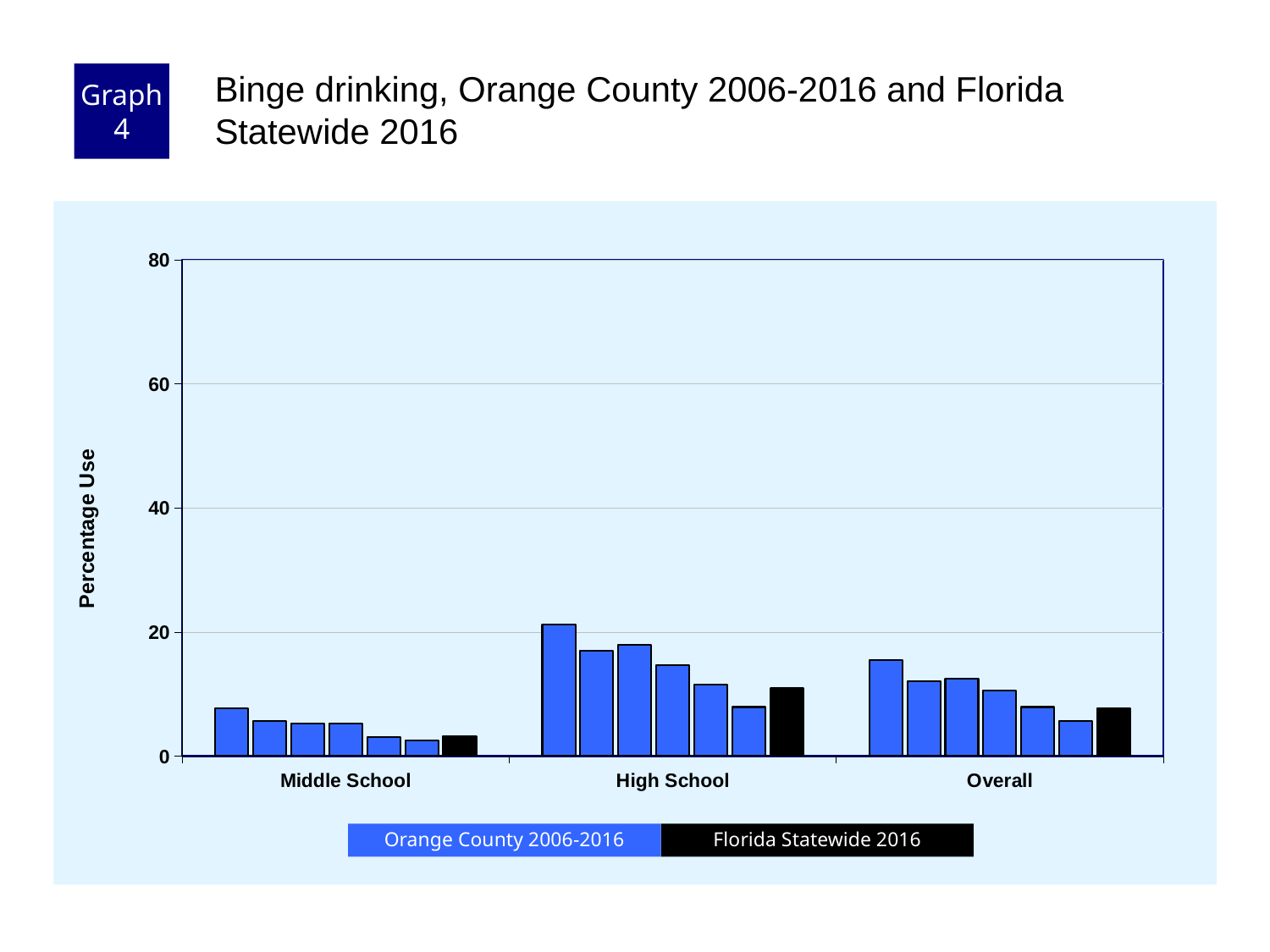
Is the Florida Statewide 2016 value for High School greater or less than 20? less How many categories are shown on the x axis? 3 Which colour represents Florida Statewide 2016 in the legend? Black Is the Florida Statewide 2016 value for Middle School greater or less than 20? less Is the Florida Statewide 2016 value for High School larger or smaller than the Florida Statewide 2016 value for Middle School? larger How many series does the legend list? 2 Is the Florida Statewide 2016 bar for Overall larger or smaller than the Florida Statewide 2016 bar for High School? smaller Which category has the tallest bars overall? High School Do the Orange County 2006-2016 bars for High School generally rise or fall from left to right? fall What kind of chart is shown on the slide? Bar chart What is the label on the y axis? Percentage Use Which category has the shortest bars overall? Middle School